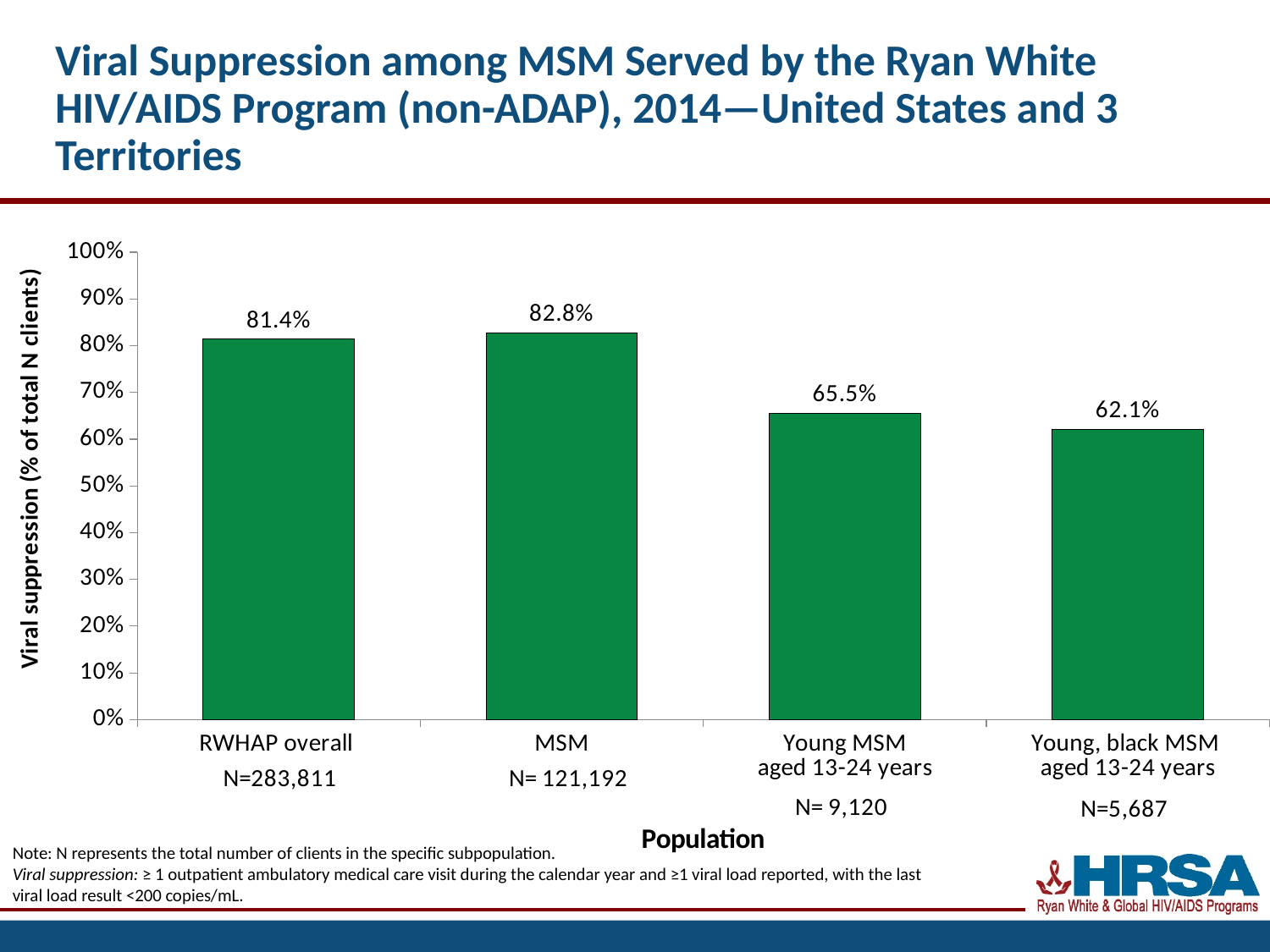
How many populations are shown on the chart? 4 Is the value for Young MSM aged 13-24 years greater or less than 70%? less What is the viral suppression percentage for RWHAP overall? 81.4% What is the viral suppression percentage for MSM? 82.8% What is the viral suppression percentage for Young, black MSM aged 13-24 years? 62.1% What kind of chart is shown on the slide? Bar chart What is the N for the Young MSM aged 13-24 years population? N= 9,120 Which population has the highest viral suppression percentage? MSM What is the label of the x axis? Population Which population has the lowest viral suppression percentage? Young, black MSM aged 13-24 years What is the difference in viral suppression between MSM and Young MSM aged 13-24 years? 17.3% Which has a higher viral suppression percentage, RWHAP overall or Young MSM aged 13-24 years? RWHAP overall